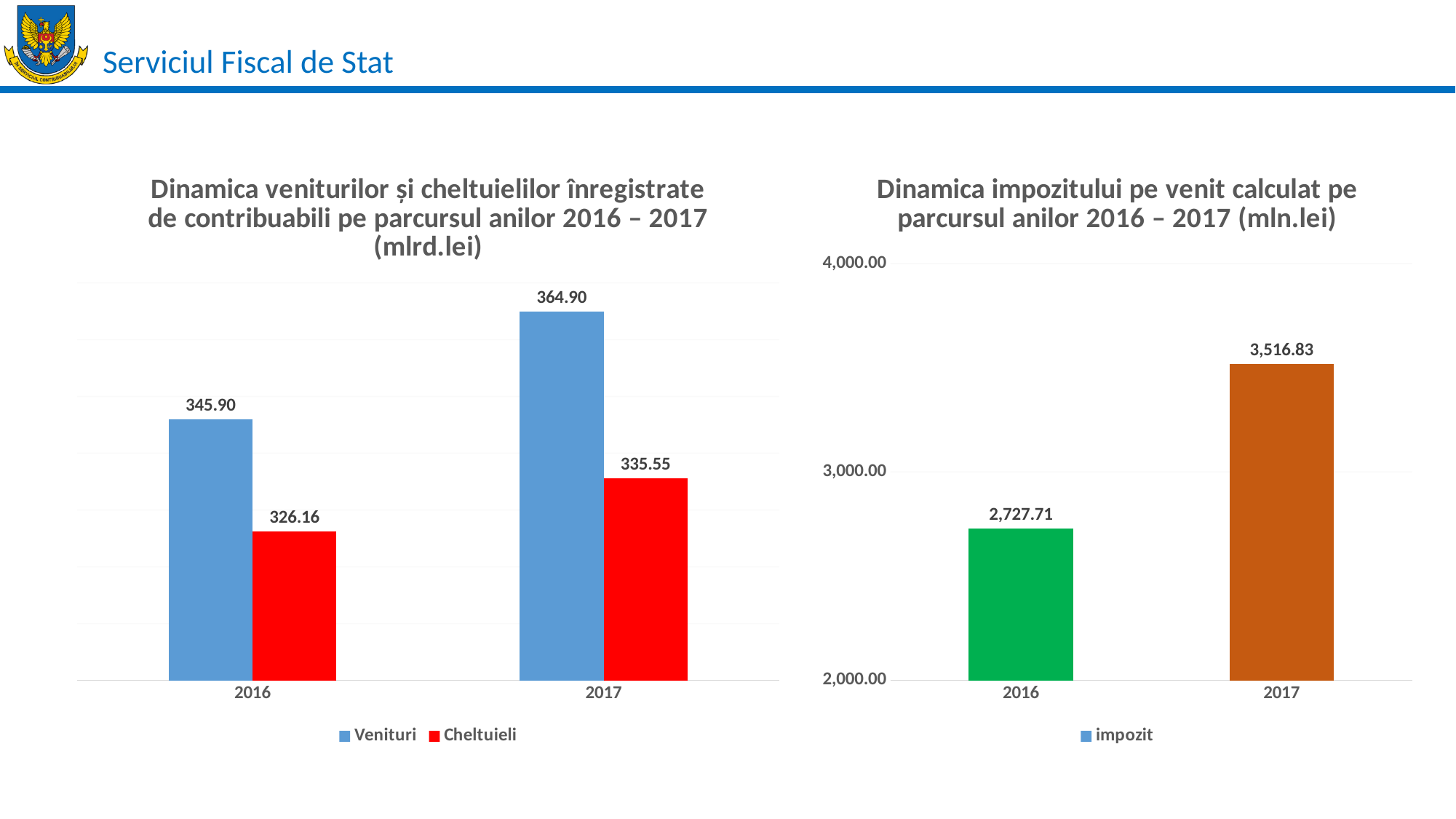
In the left chart (Dinamica veniturilor și cheltuielilor), what is the difference between Venituri and Cheltuieli in 2017? 29.35 In the right chart (Dinamica impozitului pe venit), which year has the highest value? 2017 In the left chart (Dinamica veniturilor și cheltuielilor), what is the value of Venituri for 2017? 364.90 In the left chart (Dinamica veniturilor și cheltuielilor), how many series does the legend list? 2 In the right chart (Dinamica impozitului pe venit), what is the value for 2016? 2,727.71 In the left chart (Dinamica veniturilor și cheltuielilor), does Cheltuieli rise or fall from 2016 to 2017? rise In the left chart (Dinamica veniturilor și cheltuielilor), what is the value of Cheltuieli for 2016? 326.16 In the right chart (Dinamica impozitului pe venit), is the value for 2017 greater or less than 3,000.00? greater In the left chart (Dinamica veniturilor și cheltuielilor), which is larger in 2016, Venituri or Cheltuieli? Venituri What kind of chart is the right chart (Dinamica impozitului pe venit)? bar chart In the right chart (Dinamica impozitului pe venit), what is the value for 2017? 3,516.83 In the left chart (Dinamica veniturilor și cheltuielilor), what colour are the Cheltuieli bars? red